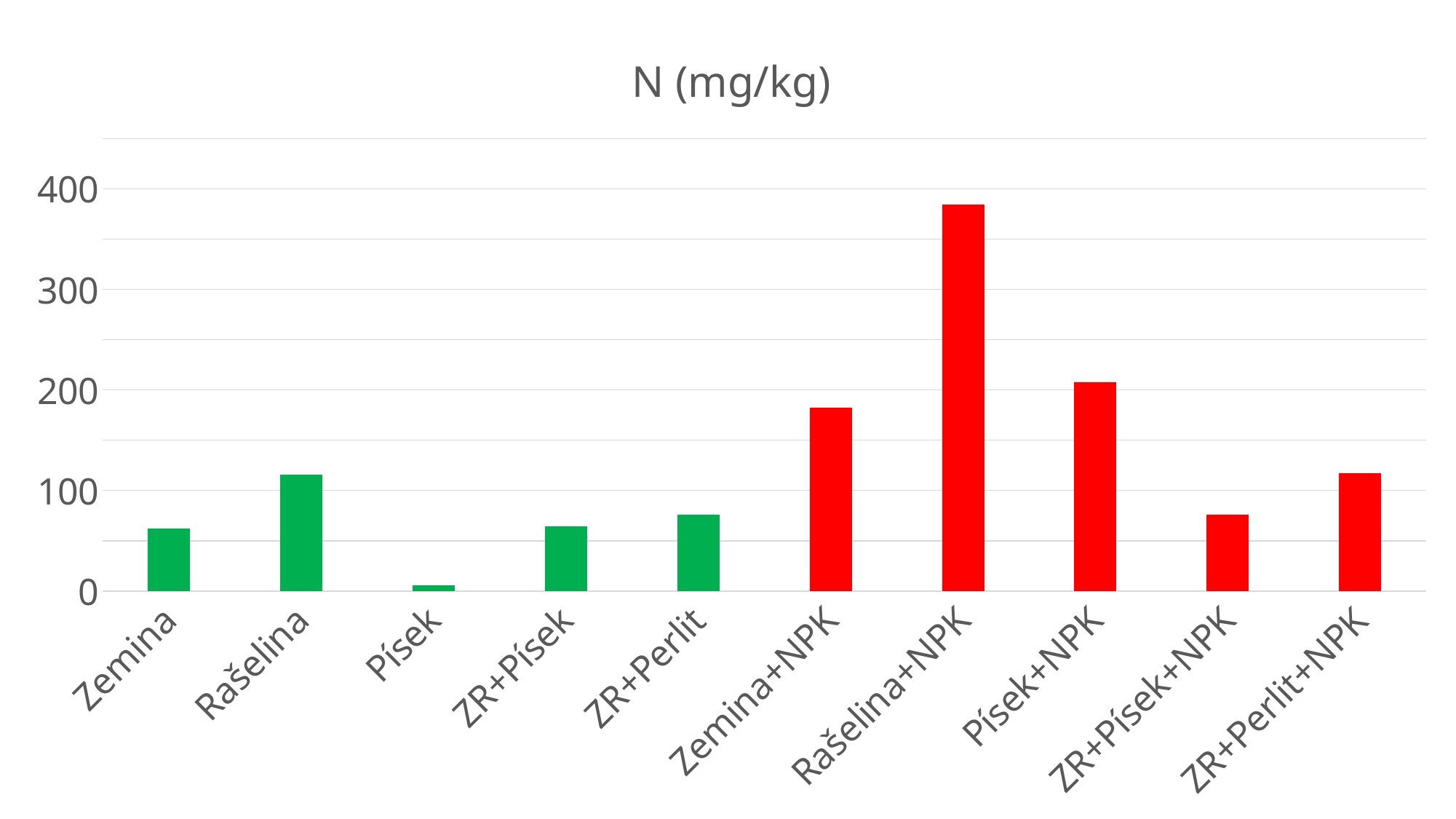
How many categories are shown on the x axis of the chart? 10 What kind of chart is shown on the slide? bar chart Which category has the lowest value in the chart? Písek What is the title of the chart? N (mg/kg) Which category has the highest value in the chart? Rašelina+NPK Is the value for Zemina greater or less than 100? less Which is larger, the value for Písek+NPK or the value for ZR+Písek+NPK? Písek+NPK Is the value for Zemina+NPK greater or less than 200? less What colour are the bars for the categories with +NPK in the chart? red Which is larger, the value for Rašelina or the value for Zemina? Rašelina Is the value for Rašelina+NPK greater or less than 300? greater